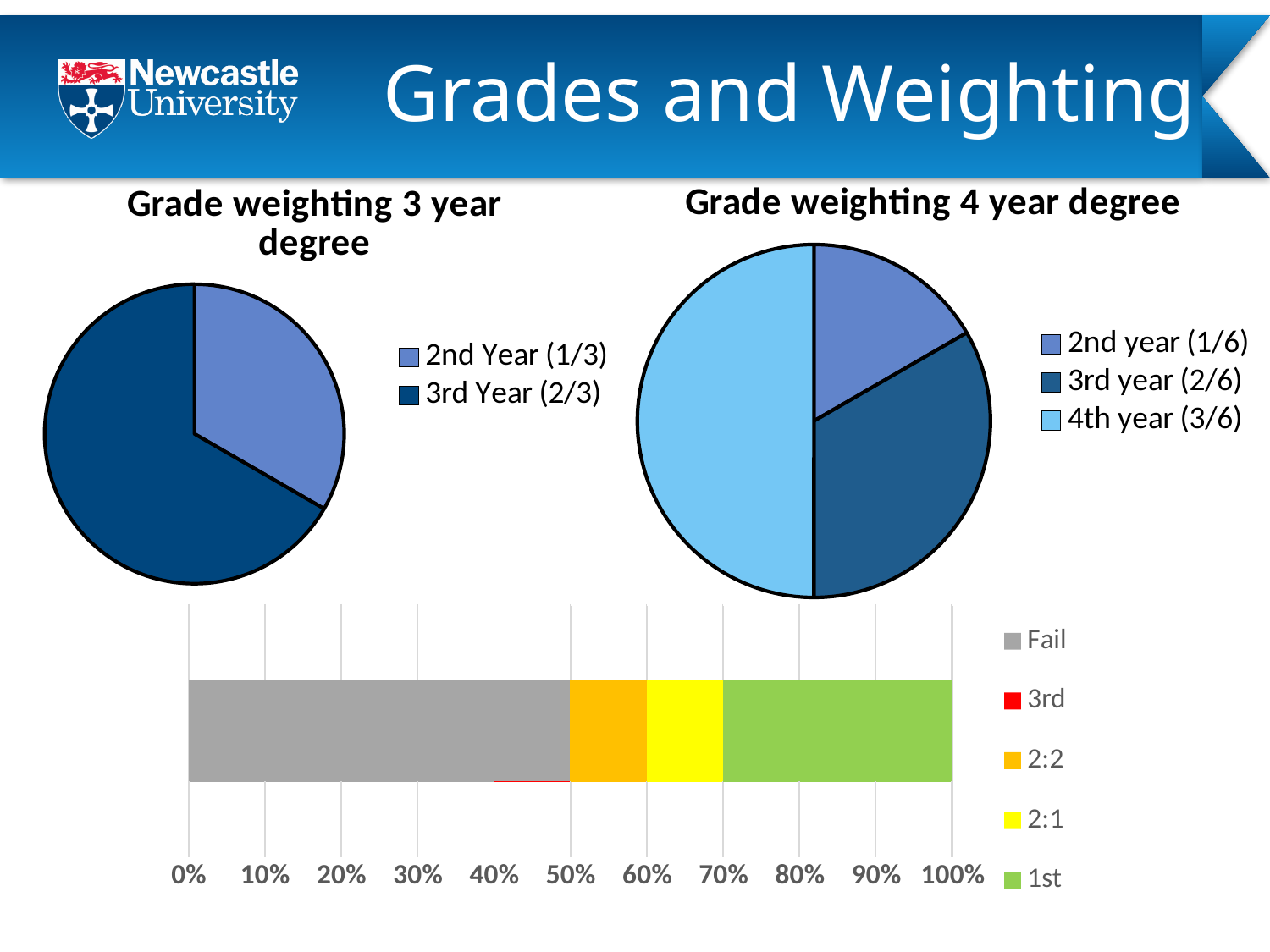
How many entries does the legend of the bar chart at the bottom of the slide list? 5 In the "Grade weighting 4 year degree" chart, what share of the pie does 3rd year represent according to the legend? 2/6 In the bar chart at the bottom of the slide, which segment is larger, 2:1 or 1st? 1st In the "Grade weighting 4 year degree" chart, which slice is the smallest? 2nd year (1/6) In the "Grade weighting 4 year degree" chart, which slice is the largest? 4th year (3/6) In the "Grade weighting 3 year degree" chart, which slice is the largest? 3rd Year (2/3) In the bar chart at the bottom of the slide, at what percentage does the Fail segment end? 50% What kind of chart is the "Grade weighting 3 year degree" chart? pie chart In the "Grade weighting 3 year degree" chart, what share of the pie does 3rd Year represent according to the legend? 2/3 How many slices does the "Grade weighting 3 year degree" pie chart have? 2 What kind of chart is the chart at the bottom of the slide? bar chart How many entries does the legend of the "Grade weighting 4 year degree" chart list? 3